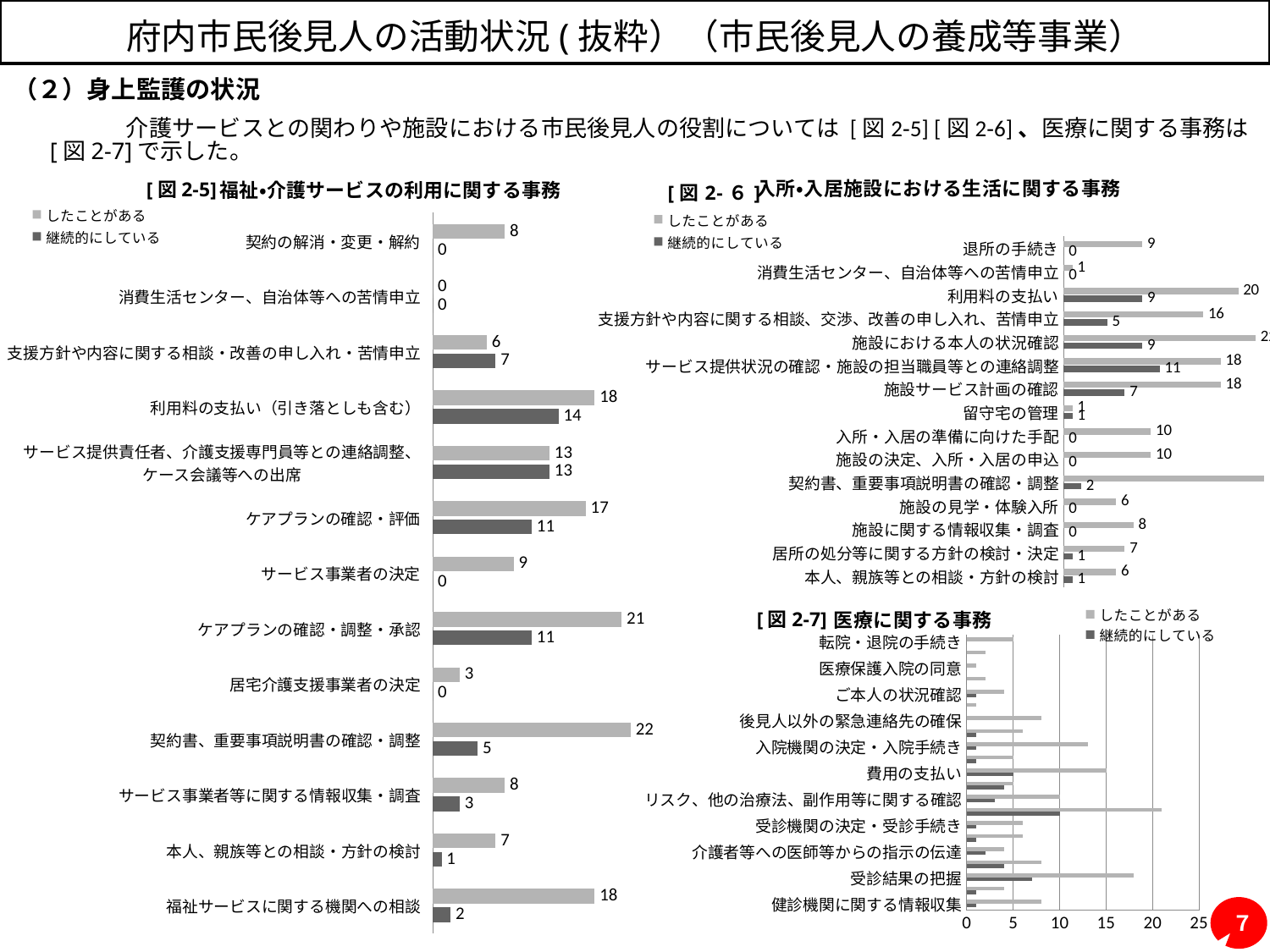
In the chart [図 2-5] 福祉・介護サービスの利用に関する事務, what is the したことがある value for 契約書、重要事項説明書の確認・調整? 22 In the chart [図 2-6] 入所・入居施設における生活に関する事務, what is the difference between the したことがある and 継続的にしている values for 施設サービス計画の確認? 11 In the chart [図 2-6] 入所・入居施設における生活に関する事務, what is the 継続的にしている value for サービス提供状況の確認・施設の担当職員等との連絡調整? 11 In the chart [図 2-5] 福祉・介護サービスの利用に関する事務, what is the difference between the したことがある and 継続的にしている values for ケアプランの確認・調整・承認? 10 In the chart [図 2-5] 福祉・介護サービスの利用に関する事務, how many series does the legend list? 2 In the chart [図 2-5] 福祉・介護サービスの利用に関する事務, what is the 継続的にしている value for 利用料の支払い（引き落としも含む）? 14 In the chart [図 2-6] 入所・入居施設における生活に関する事務, what is the したことがある value for 利用料の支払い? 20 In the chart [図 2-7] 医療に関する事務, is the したことがある value for 受診結果の把握 greater or less than 15? greater In the chart [図 2-5] 福祉・介護サービスの利用に関する事務, which category has the highest したことがある value? 契約書、重要事項説明書の確認・調整 What type of chart is [図 2-7] 医療に関する事務? bar chart In the chart [図 2-6] 入所・入居施設における生活に関する事務, which is larger: the したことがある value for 施設に関する情報収集・調査 or for 施設の見学・体験入所? 施設に関する情報収集・調査 In the chart [図 2-7] 医療に関する事務, is the したことがある value for リスク、他の治療法、副作用等に関する確認 greater or less than 20? less